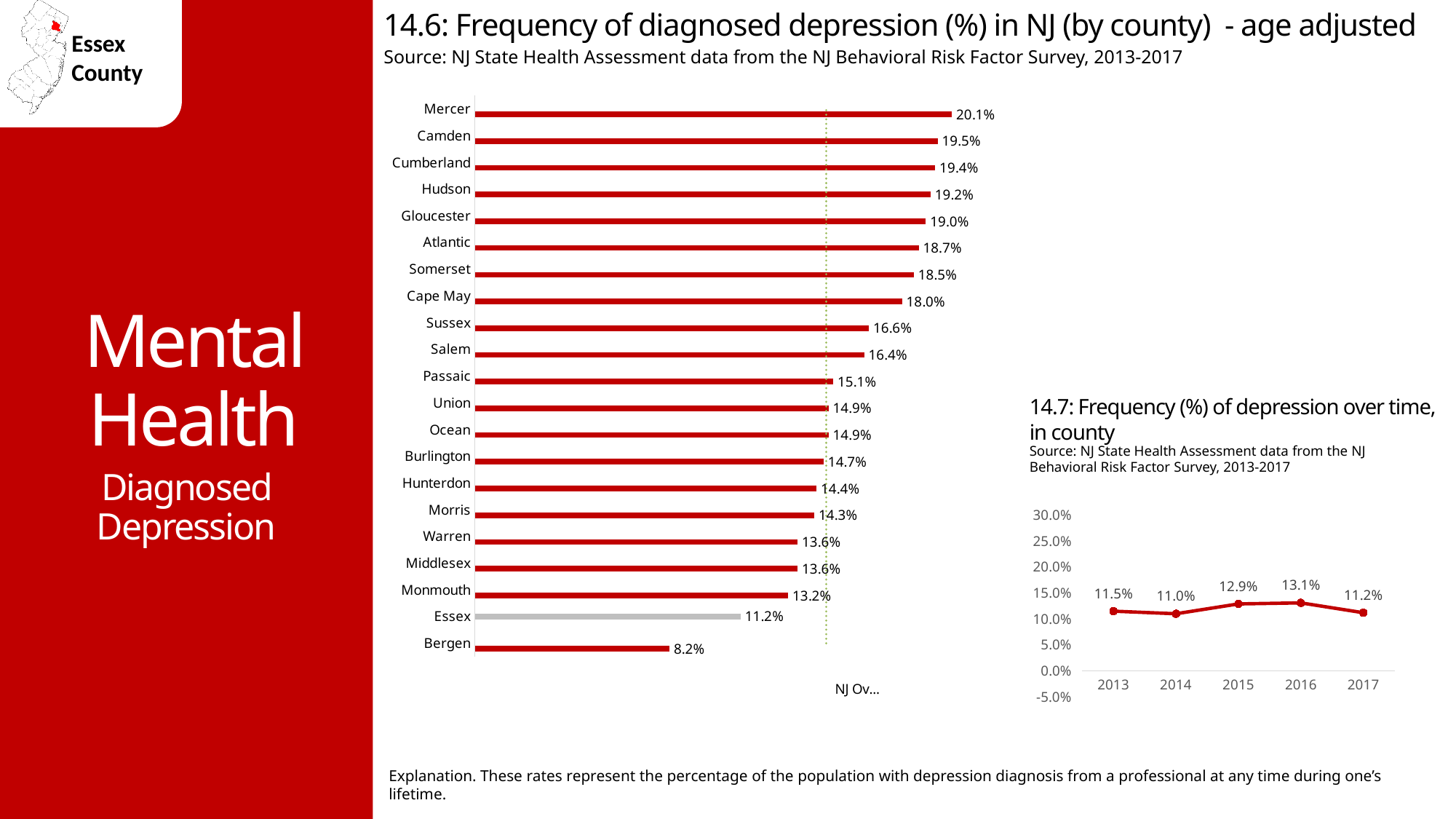
In the chart '14.6: Frequency of diagnosed depression (%) in NJ (by county) - age adjusted', which county has the lowest value? Bergen In the chart '14.7: Frequency (%) of depression over time, in county', what is the value for 2015? 12.9% In the chart '14.6: Frequency of diagnosed depression (%) in NJ (by county) - age adjusted', which county has the highest value? Mercer In the chart '14.7: Frequency (%) of depression over time, in county', what is the difference between the values for 2016 and 2014? 2.1% What kind of chart is '14.6: Frequency of diagnosed depression (%) in NJ (by county) - age adjusted'? Bar chart How many counties are shown in the chart '14.6: Frequency of diagnosed depression (%) in NJ (by county) - age adjusted'? 21 In the chart '14.6: Frequency of diagnosed depression (%) in NJ (by county) - age adjusted', what is the value for Mercer? 20.1% What kind of chart is '14.7: Frequency (%) of depression over time, in county'? Line chart In the chart '14.7: Frequency (%) of depression over time, in county', which year has the highest value? 2016 In the chart '14.6: Frequency of diagnosed depression (%) in NJ (by county) - age adjusted', what is the value for Essex? 11.2% In the chart '14.6: Frequency of diagnosed depression (%) in NJ (by county) - age adjusted', which is larger, the value for Hudson or the value for Cape May? Hudson In the chart '14.6: Frequency of diagnosed depression (%) in NJ (by county) - age adjusted', what is the difference between the values for Mercer and Bergen? 11.9%